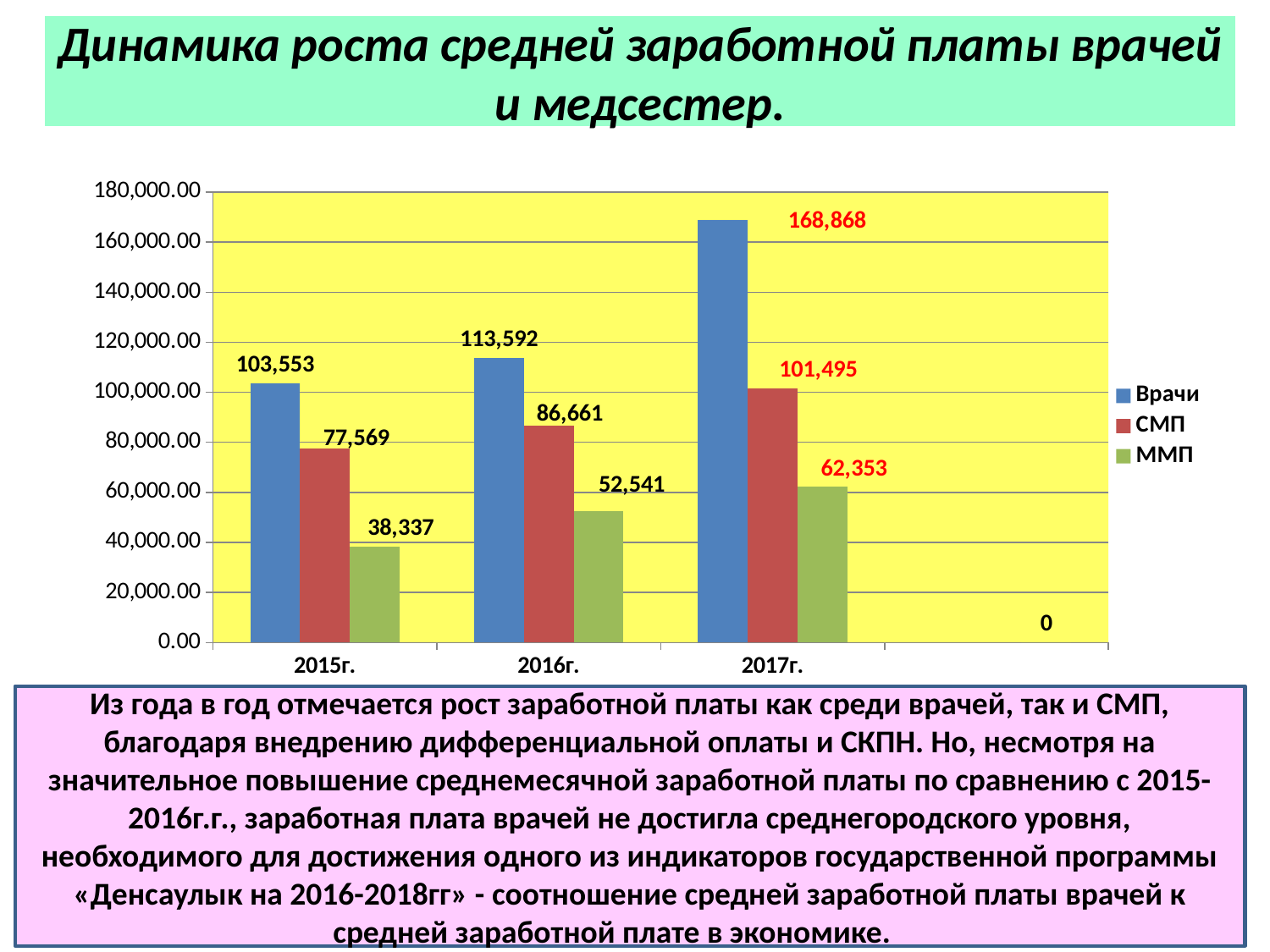
What is the value for Врачи in 2017г.? 168,868 Do the values for СМП rise or fall from 2015г. to 2017г.? Rise What is the value for Врачи in 2016г.? 113,592 In which year is the value for ММП the lowest? 2015г. What is the difference between the Врачи values in 2017г. and 2015г.? 65,315 What kind of chart is shown on the slide? Bar chart Which is larger in 2017г.: the value for СМП or the value for ММП? СМП What is the value for ММП in 2016г.? 52,541 In which year is the value for Врачи the highest? 2017г. What is the value for СМП in 2015г.? 77,569 How many series does the legend list? 3 What is the difference between the Врачи and СМП values in 2016г.? 26,931